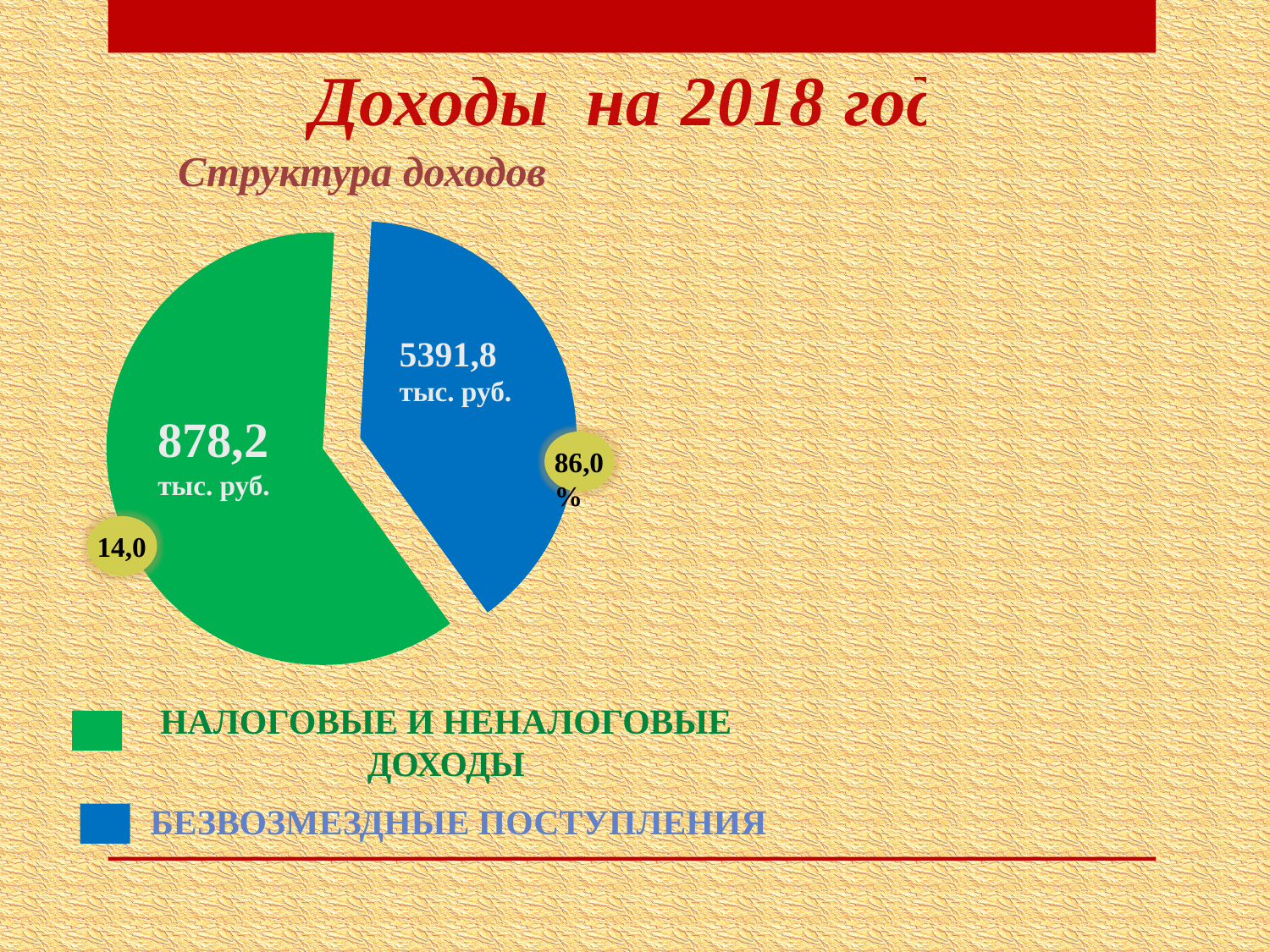
What is the total of the two values shown in the pie chart? 6270,0 тыс. руб. What percentage share is labelled for БЕЗВОЗМЕЗДНЫЕ ПОСТУПЛЕНИЯ? 86,0 % Which category has the larger value in тыс. руб., НАЛОГОВЫЕ И НЕНАЛОГОВЫЕ ДОХОДЫ or БЕЗВОЗМЕЗДНЫЕ ПОСТУПЛЕНИЯ? БЕЗВОЗМЕЗДНЫЕ ПОСТУПЛЕНИЯ How many slices does the pie chart have? 2 What percentage share is labelled for НАЛОГОВЫЕ И НЕНАЛОГОВЫЕ ДОХОДЫ? 14,0 How many entries does the legend list? 2 What is the difference between the values for БЕЗВОЗМЕЗДНЫЕ ПОСТУПЛЕНИЯ and НАЛОГОВЫЕ И НЕНАЛОГОВЫЕ ДОХОДЫ? 4513,6 тыс. руб. What kind of chart is shown on the slide? Pie chart Which colour represents БЕЗВОЗМЕЗДНЫЕ ПОСТУПЛЕНИЯ in the chart? Blue What is the value for НАЛОГОВЫЕ И НЕНАЛОГОВЫЕ ДОХОДЫ? 878,2 тыс. руб. What is the title of the chart? Структура доходов What is the value for БЕЗВОЗМЕЗДНЫЕ ПОСТУПЛЕНИЯ? 5391,8 тыс. руб.